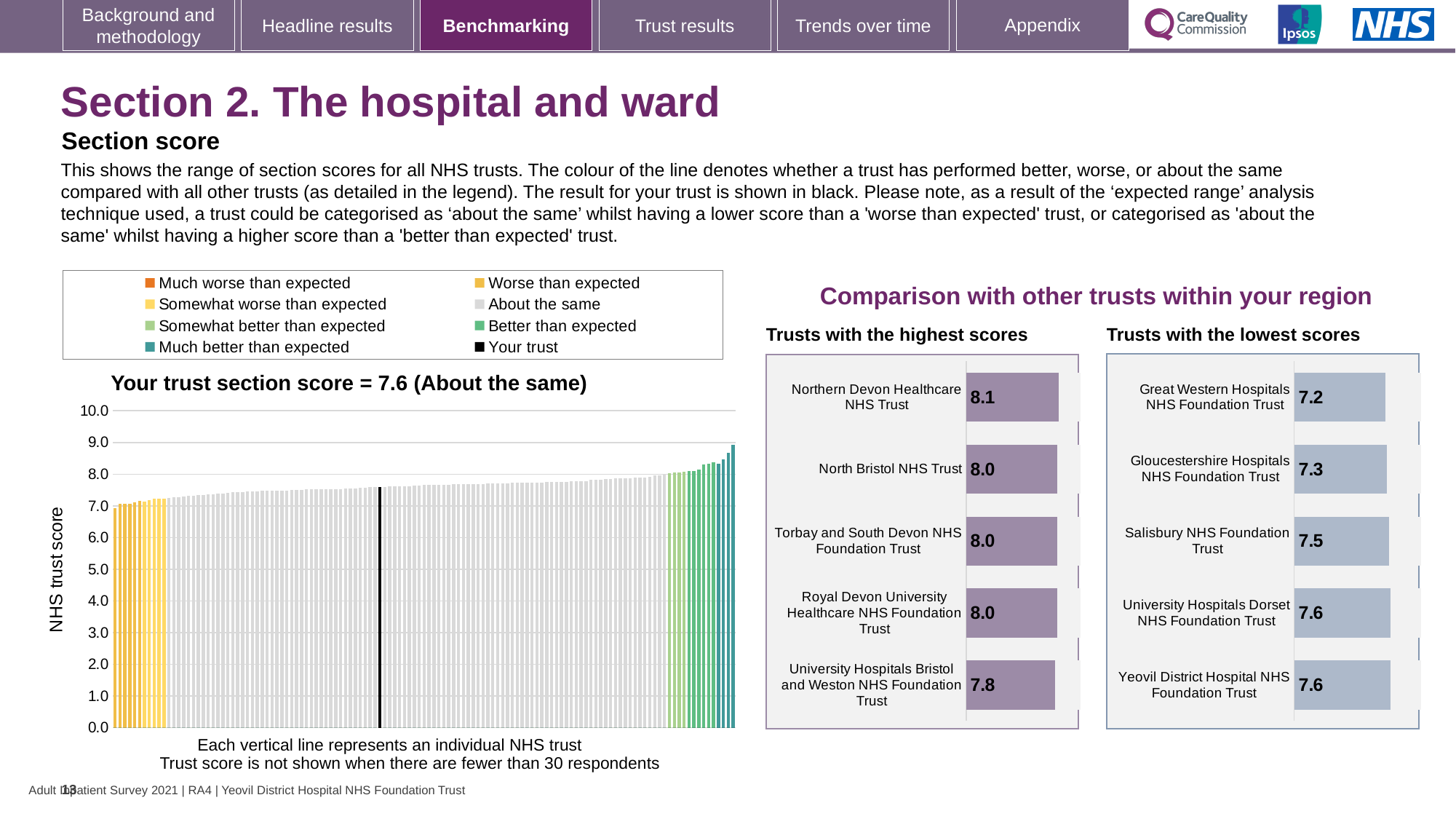
In the main 'Your trust section score' chart, is the value for your trust (the black line) greater or less than 5.0? greater In the main 'Your trust section score' chart, do the trust scores rise or fall from left to right? rise In the 'Trusts with the highest scores' chart, what is the score for Northern Devon Healthcare NHS Trust? 8.1 In the 'Trusts with the highest scores' chart, what is the difference between the scores of Northern Devon Healthcare NHS Trust and University Hospitals Bristol and Weston NHS Foundation Trust? 0.3 In the main 'Your trust section score' chart, what is the section score for your trust? 7.6 In the 'Trusts with the lowest scores' chart, which trust has the lowest score? Great Western Hospitals NHS Foundation Trust In the 'Trusts with the lowest scores' chart, what is the score for Salisbury NHS Foundation Trust? 7.5 In the 'Trusts with the highest scores' chart, which trust has the highest score? Northern Devon Healthcare NHS Trust How many entries does the legend above the main 'Your trust section score' chart list? 8 In the 'Trusts with the lowest scores' chart, which has the larger score: Gloucestershire Hospitals NHS Foundation Trust or Yeovil District Hospital NHS Foundation Trust? Yeovil District Hospital NHS Foundation Trust In the 'Trusts with the lowest scores' chart, what is the score for Great Western Hospitals NHS Foundation Trust? 7.2 In the 'Trusts with the highest scores' chart, how many trusts are listed? 5